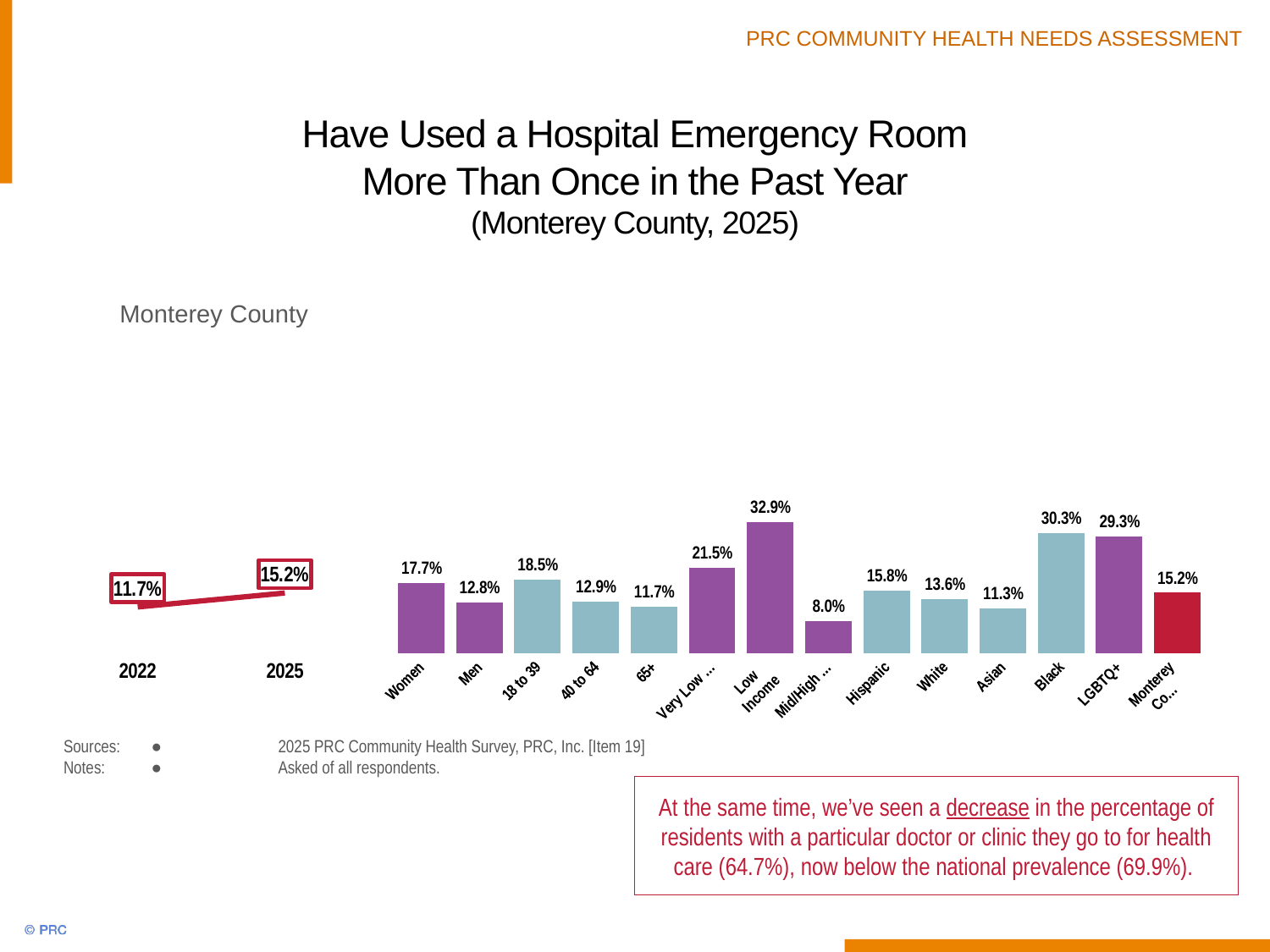
How many categories are shown in the bar chart on the right? 14 What kind of chart is the chart on the right of the slide? bar chart In the bar chart on the right, which category has the highest value? Low Income In the bar chart on the right, what is the difference between the values for Women and Men? 4.9% In the bar chart on the right, which category has the lowest value? Mid/High ... In the bar chart on the right, what is the value for Women? 17.7% In the bar chart on the right, which is larger, the value for Hispanic or the value for White? Hispanic In the line chart on the left, what is the difference between the 2025 and 2022 values? 3.5% In the bar chart on the right, what is the value for Black? 30.3% In the line chart on the left, does the value rise or fall from 2022 to 2025? rise In the line chart on the left, what is the value for 2022? 11.7% In the line chart on the left, what is the value for 2025? 15.2%